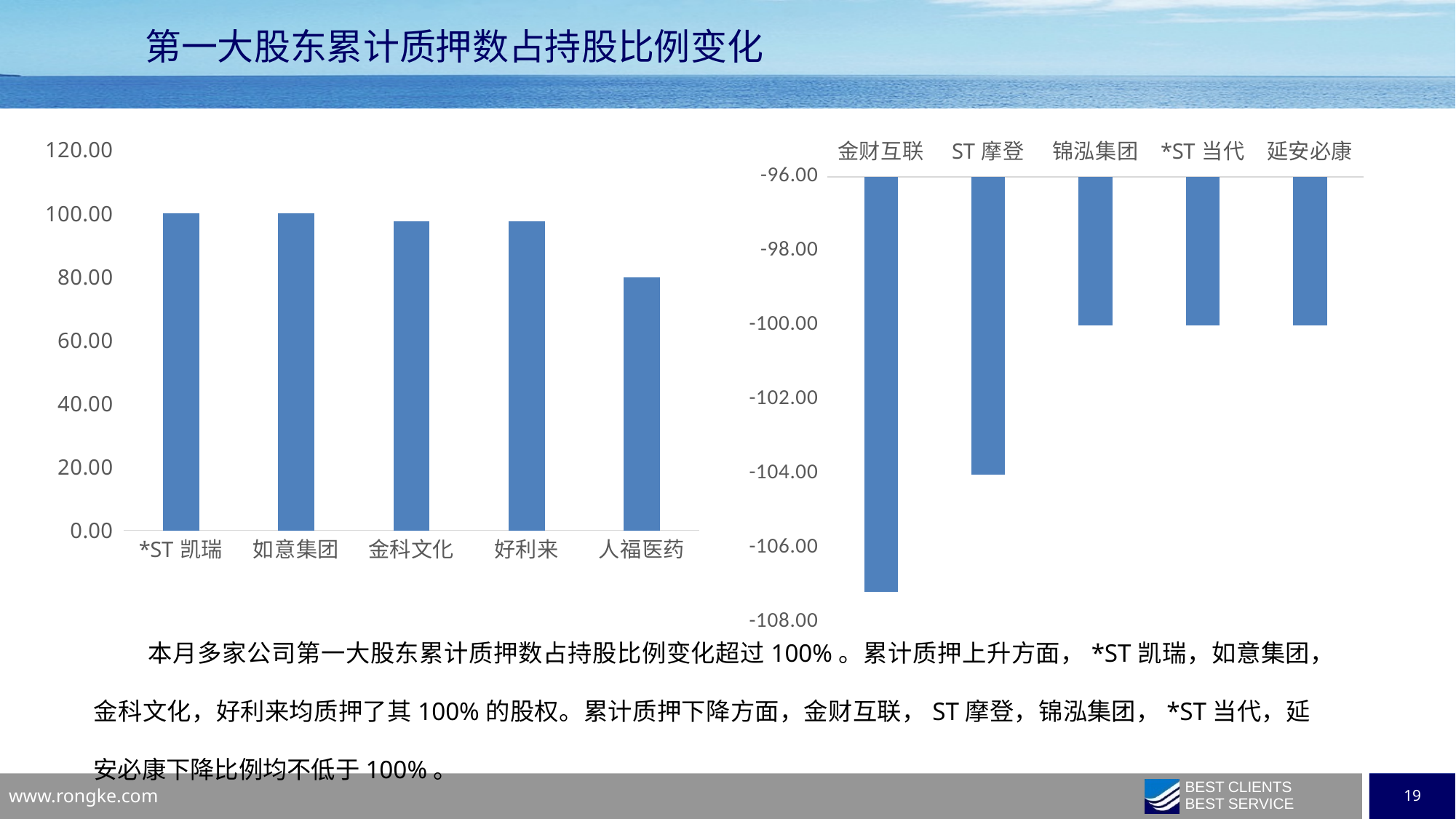
In the left chart, is the value for 人福医药 greater or less than 100.00? less What kind of chart is the left chart on the slide? bar chart In the right chart, which category has the lowest (most negative) value? 金财互联 In the left chart, is the value for 金科文化 greater or less than 80.00? greater In the left chart, which category has the lowest value? 人福医药 In the right chart, is the value for ST 摩登 greater or less than -102.00? less In the left chart, which is larger, the value for 好利来 or the value for 人福医药? 好利来 How many categories are shown in the left chart? 5 How many categories are shown in the right chart? 5 What is the title of the slide? 第一大股东累计质押数占持股比例变化 In the left chart, what is the value for *ST 凯瑞? 100.00